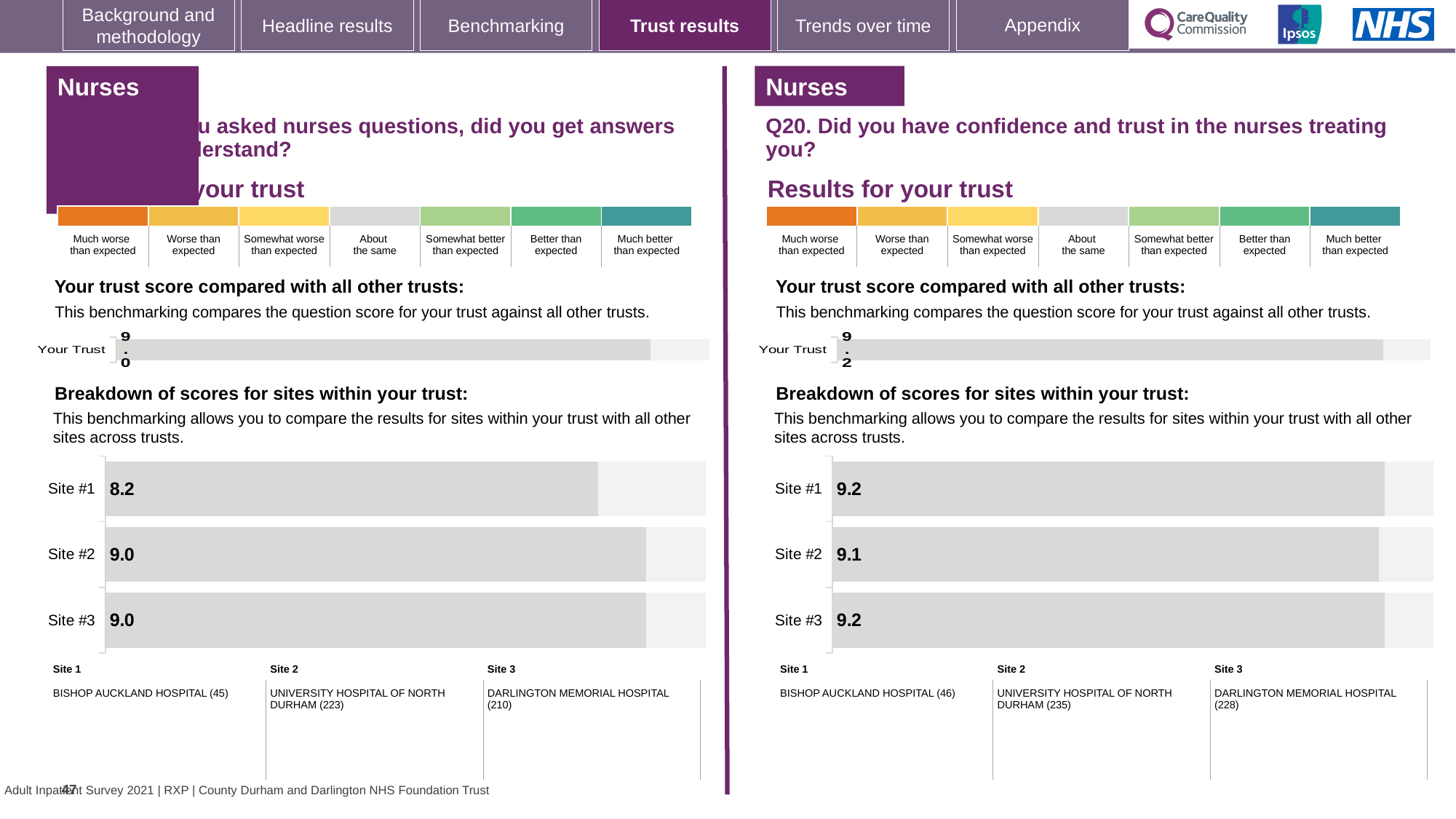
In the 'Your trust score compared with all other trusts' chart on the left half of the slide, what is the score shown for Your Trust? 9.0 In the site breakdown chart on the left half of the slide, what is the score for Site #1? 8.2 In the site breakdown chart on the left half of the slide, which site has the lowest score? Site #1 In the site breakdown chart for Q20 on the right half of the slide, what is the score for Site #3? 9.2 In the 'Your trust score compared with all other trusts' chart for Q20 on the right half of the slide, what is the score shown for Your Trust? 9.2 What type of chart is used for the breakdown of scores for sites on the right half of the slide? Bar chart In the site breakdown chart for Q20 (confidence and trust in the nurses) on the right half of the slide, what is the score for Site #2? 9.1 In the site breakdown chart for Q20 on the right half of the slide, what is the difference between the scores for Site #1 and Site #2? 0.1 In the site breakdown chart on the left half of the slide, what is the score for Site #2? 9.0 In the site breakdown chart on the left half of the slide, what is the difference between the scores for Site #2 and Site #1? 0.8 How many sites are shown in the site breakdown chart on the left half of the slide? 3 In the site breakdown chart for Q20 on the right half of the slide, which site has the lowest score? Site #2